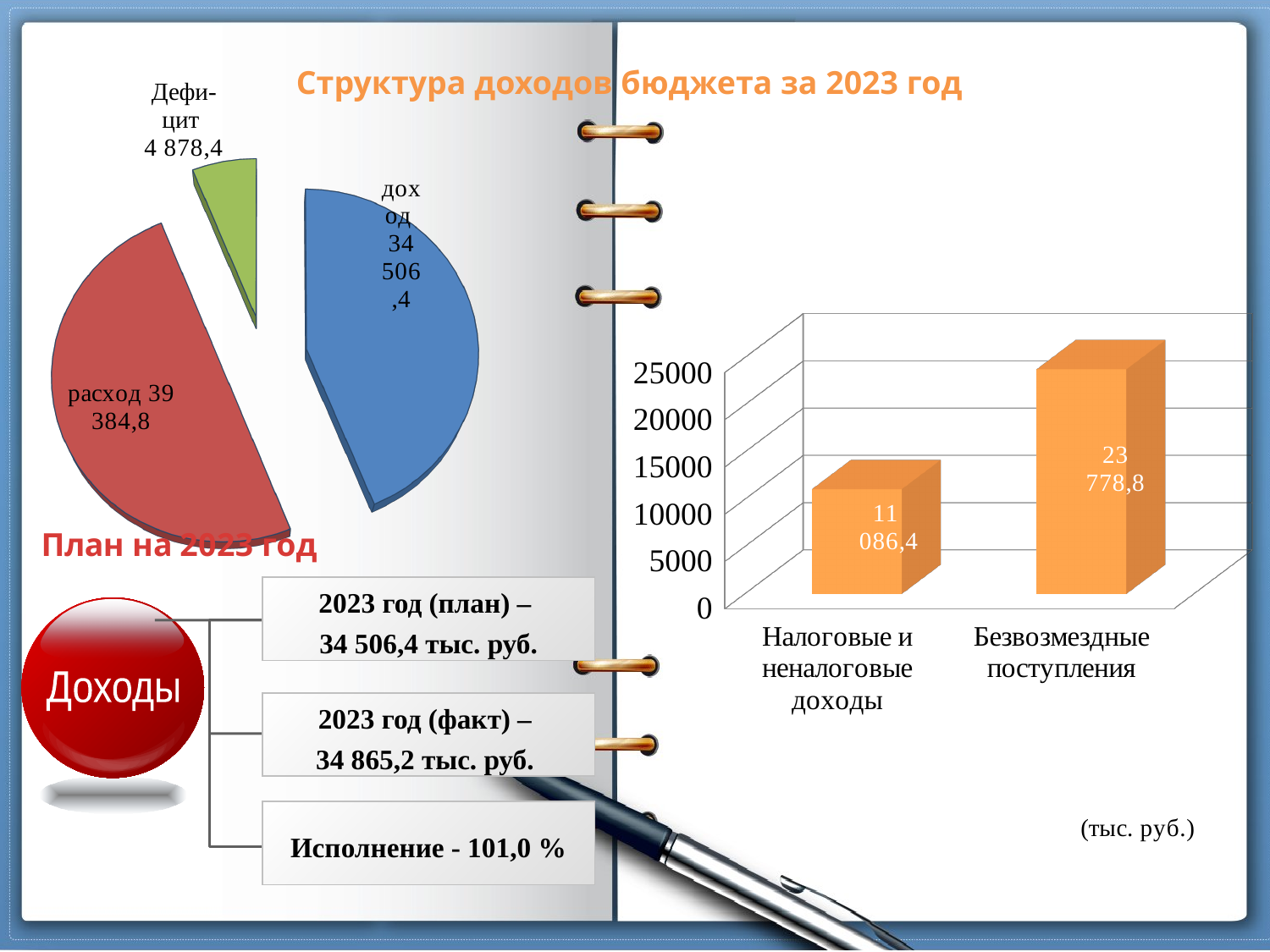
On the bar chart titled 'Структура доходов бюджета за 2023 год', is the value for 'Налоговые и неналоговые доходы' greater or less than 10000? greater On the pie chart on the left side of the slide, which slice is the smallest? Дефицит On the pie chart on the left side of the slide, how many slices are there? 3 On the pie chart on the left side of the slide, what is the value for 'расход'? 39 384,8 On the bar chart titled 'Структура доходов бюджета за 2023 год', what is the value for 'Налоговые и неналоговые доходы'? 11 086,4 On the bar chart titled 'Структура доходов бюджета за 2023 год', what is the total of the two bars? 34 865,2 On the bar chart titled 'Структура доходов бюджета за 2023 год', what is the difference between 'Безвозмездные поступления' and 'Налоговые и неналоговые доходы'? 12 692,4 What kind of chart is the chart on the right side of the slide? bar chart On the bar chart titled 'Структура доходов бюджета за 2023 год', what is the value for 'Безвозмездные поступления'? 23 778,8 On the pie chart on the left side of the slide, what is the difference between 'расход' and 'доход'? 4 878,4 On the bar chart titled 'Структура доходов бюджета за 2023 год', how many bars are shown? 2 On the bar chart titled 'Структура доходов бюджета за 2023 год', which category has the highest value? Безвозмездные поступления